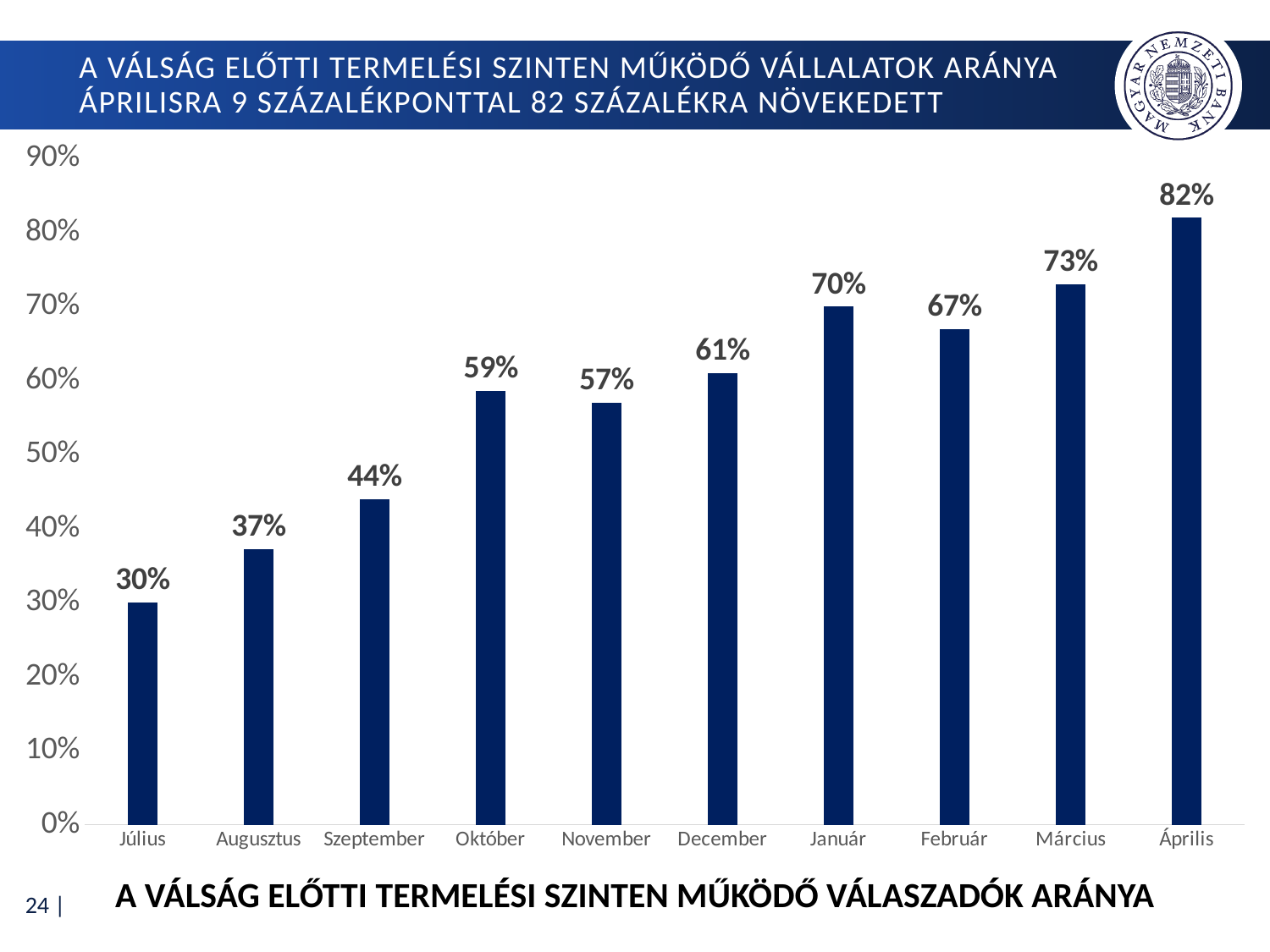
Which month has the lowest value? Július What is the value for Július? 30% What is the difference between the values for Április and Március? 9 percentage points Do the values generally rise or fall from Július to Április? Rise Which is larger, the value for November or the value for December? December Is the value for Január greater or less than 60%? greater What is the difference between the values for Október and November? 2 percentage points How many months are shown on the x axis? 10 What is the value for Október? 59% What kind of chart is shown on the slide? Bar chart What is the value for Február? 67% Which month has the highest value? Április